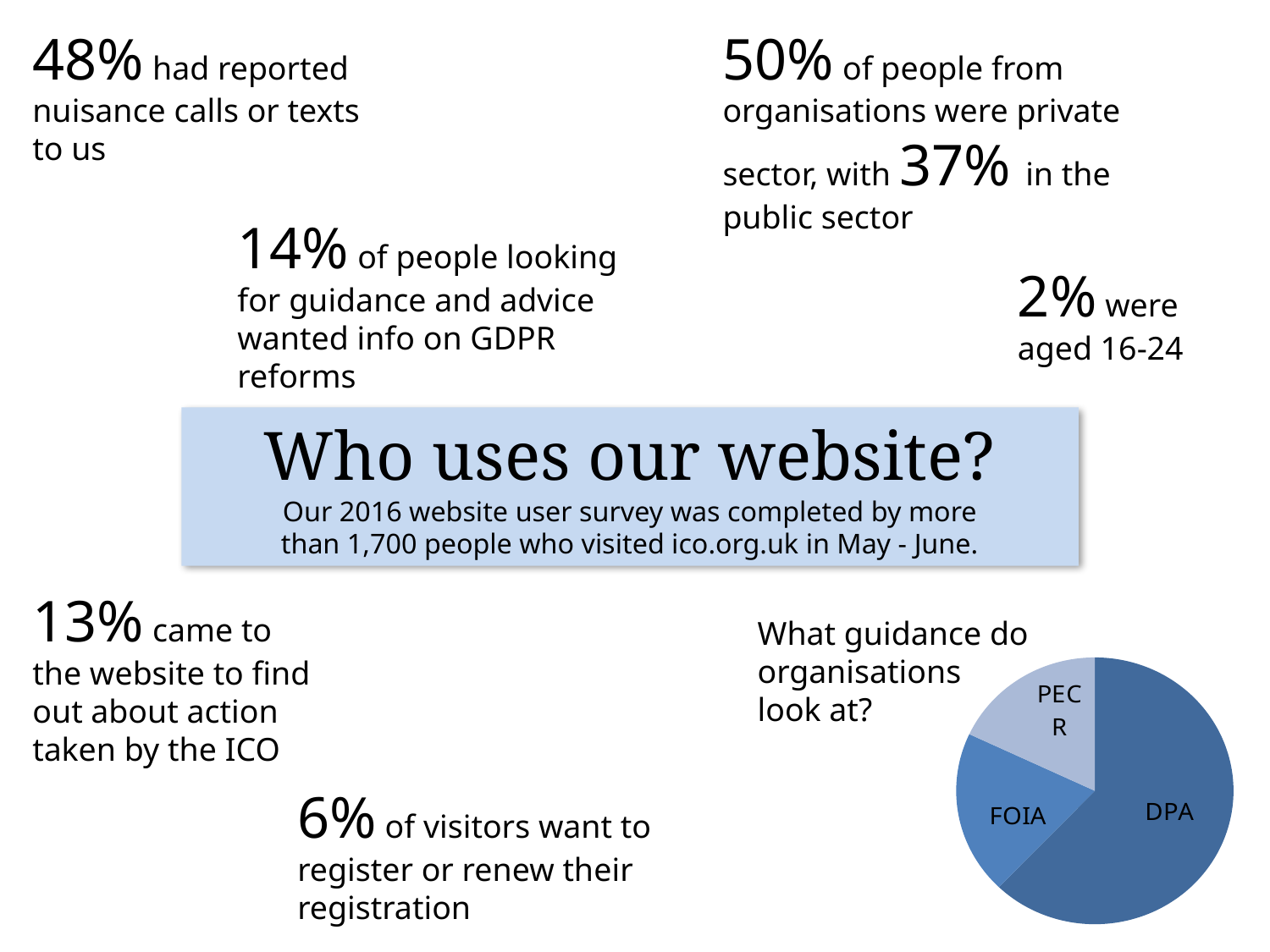
Which slice is larger in the pie chart, DPA or FOIA? DPA What kind of chart is shown on the slide? pie chart Which category has the smallest slice in the pie chart? PECR What question does the pie chart's title ask? What guidance do organisations look at? Which slice is larger in the pie chart, FOIA or PECR? FOIA Is the DPA slice greater or less than half of the pie chart? greater How many slices does the pie chart have? 3 Which slice of the pie chart is shown in the lightest colour? PECR Which category has the largest slice in the pie chart? DPA